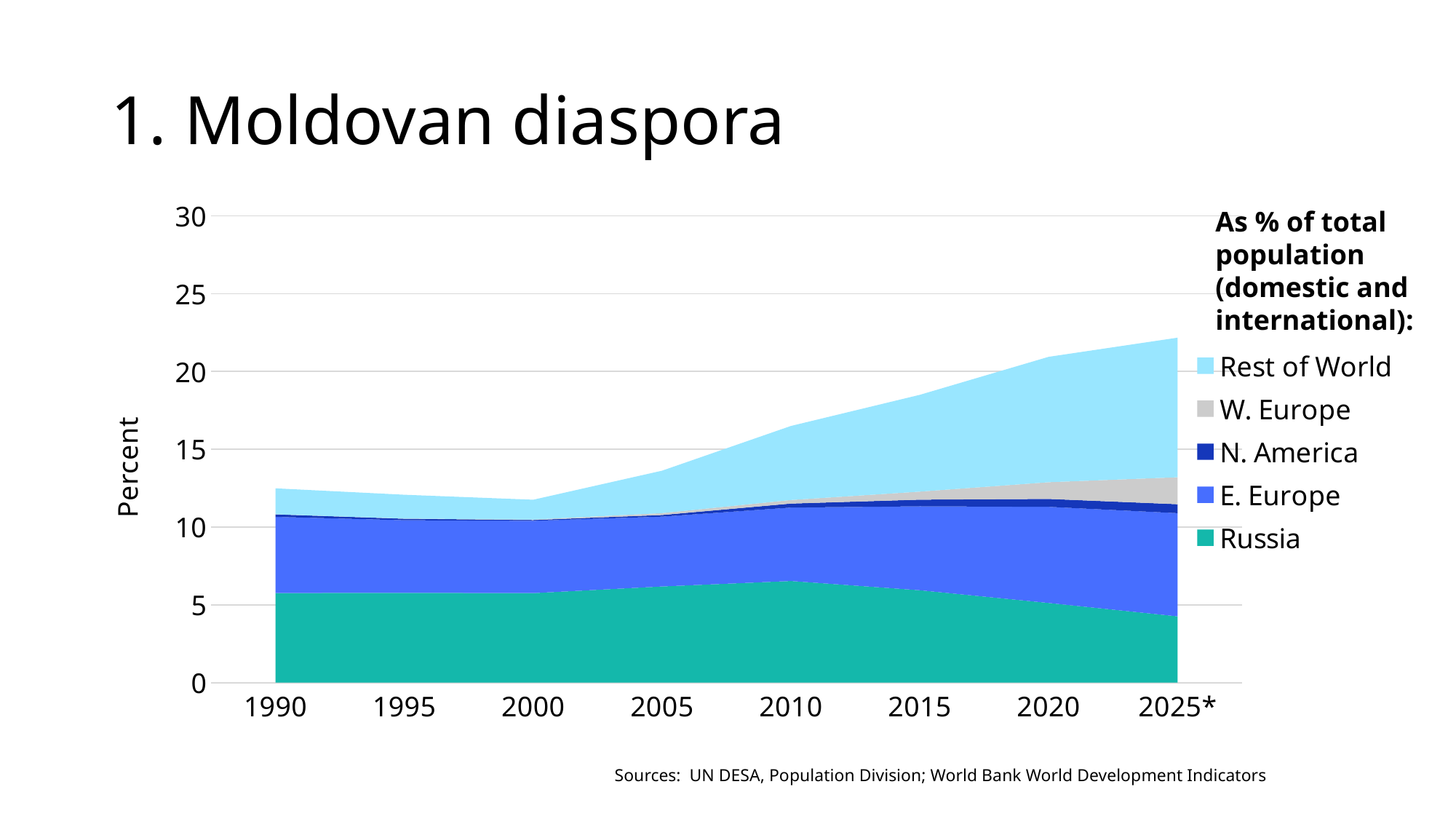
In 2025*, which is larger: Rest of World or Russia? Rest of World How many years are marked along the x axis? 8 Does the total stacked value rise or fall from 2000 to 2025*? rise Which series is at the bottom of the stack? Russia Is the value for Russia in 2025* greater or less than 5? less How many series does the legend list? 5 What is the label on the y axis? Percent What kind of chart is shown on the slide? Stacked area chart Is the total stacked value for 2025* greater or less than 20? greater In which year is the total stacked value highest? 2025* Is the total stacked value for 1990 greater or less than 15? less